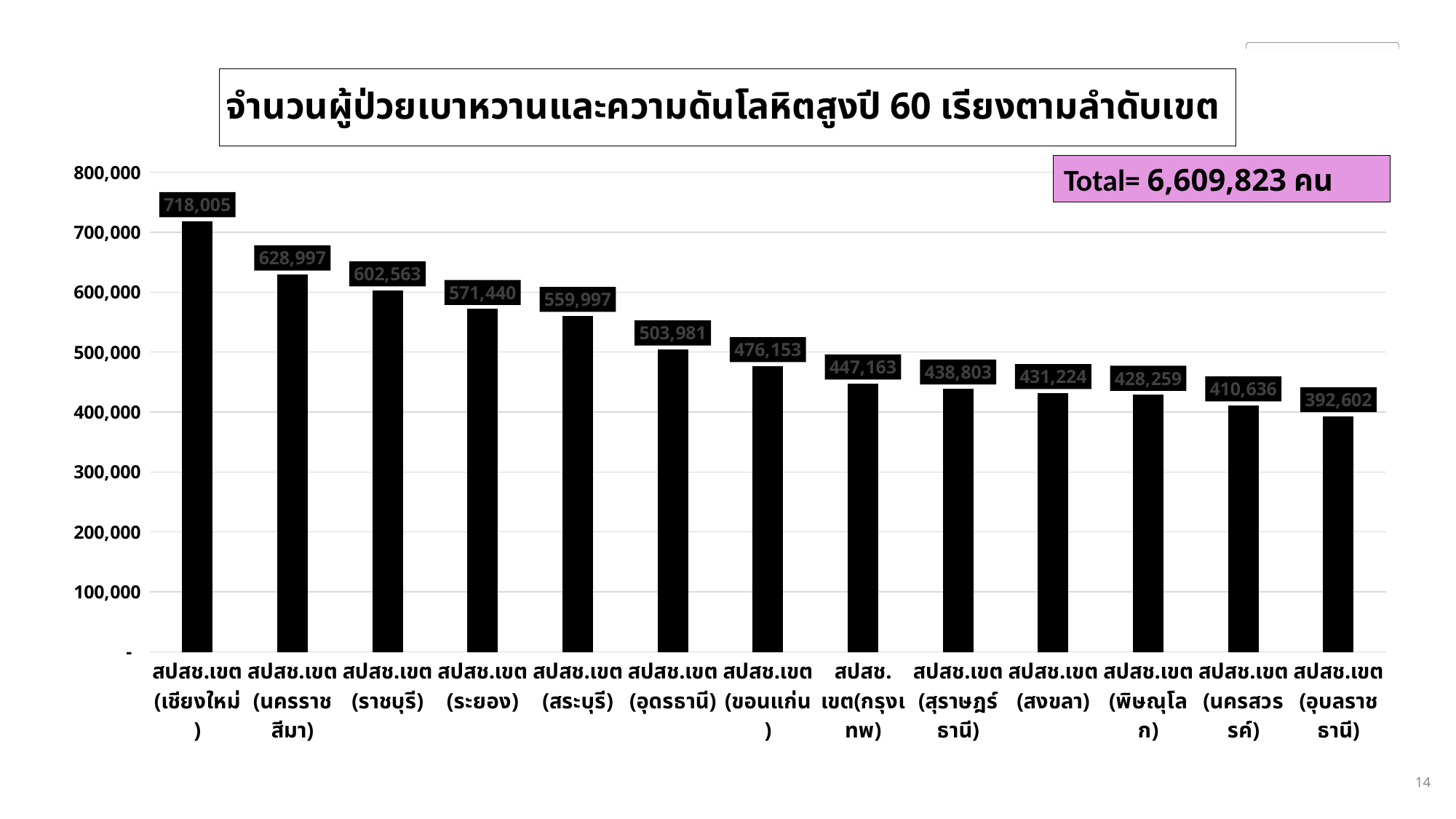
Which category has the lowest value? สปสช.เขต (อุบลราชธานี) What is the value for สปสช.เขต(กรุงเทพ)? 447,163 What total is shown in the box on the slide? 6,609,823 คน What kind of chart is shown on the slide? bar chart Which category has the highest value? สปสช.เขต (เชียงใหม่) What is the value for สปสช.เขต (ขอนแก่น)? 476,153 Is the value for สปสช.เขต (สงขลา) greater or less than 500,000? less What is the difference between the values for สปสช.เขต (เชียงใหม่) and สปสช.เขต (นครราชสีมา)? 89,008 How many categories are shown in the chart? 13 Which is larger, the value for สปสช.เขต (ราชบุรี) or สปสช.เขต (อุดรธานี)? สปสช.เขต (ราชบุรี) What is the value for สปสช.เขต (เชียงใหม่)? 718,005 What is the difference between the values for สปสช.เขต (ระยอง) and สปสช.เขต (สระบุรี)? 11,443